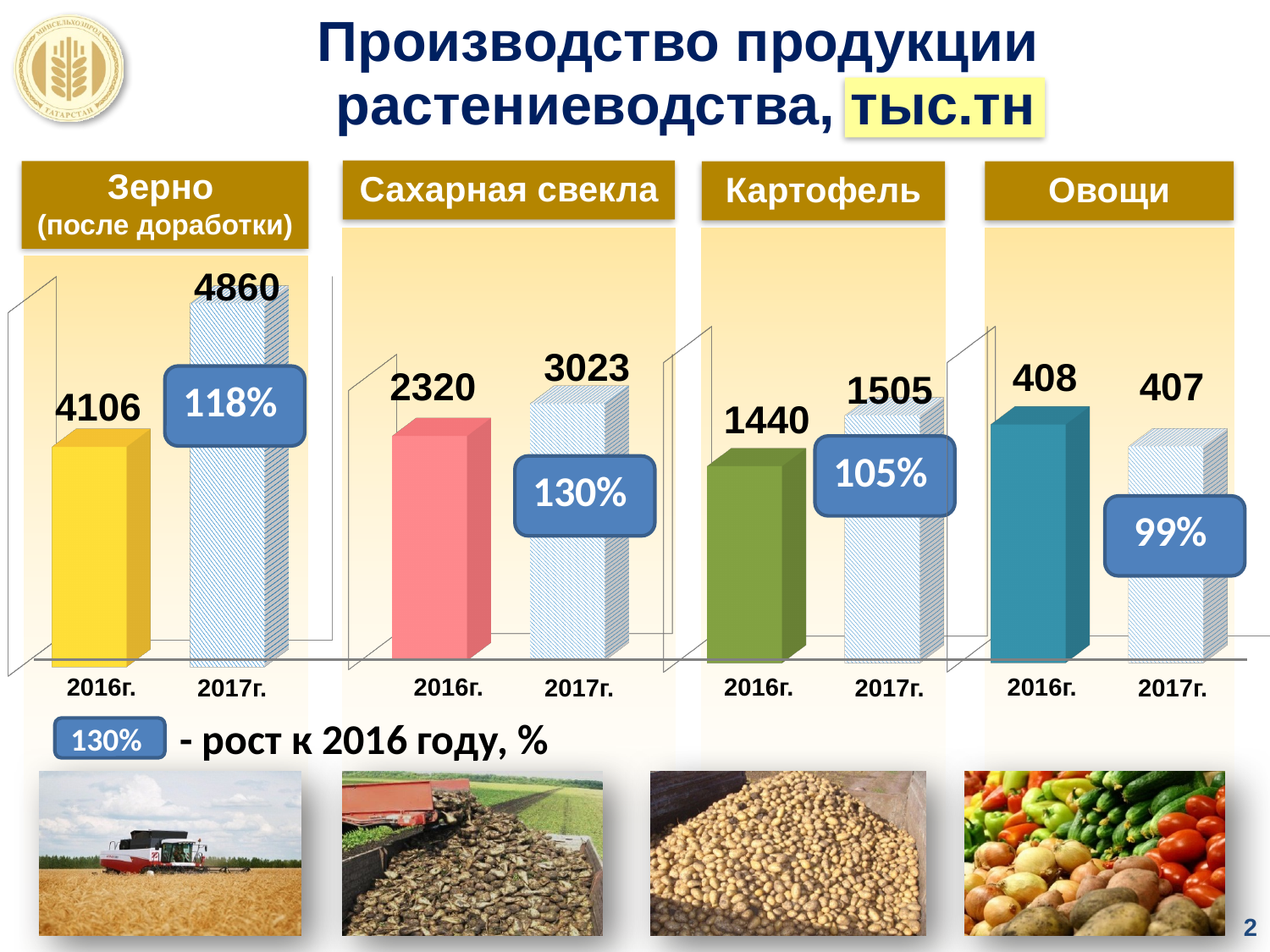
In the Зерно (после доработки) chart, what is the difference between the 2017г. and 2016г. values? 754 What kind of chart is used for Сахарная свекла? bar chart In the Сахарная свекла chart, what is the value for 2017г.? 3023 In the Сахарная свекла chart, what growth percentage relative to 2016 is shown? 130% In the Картофель chart, which year has the larger value, 2016г. or 2017г.? 2017г. In the Зерно (после доработки) chart, what is the value for 2017г.? 4860 In the Овощи chart, what growth percentage relative to 2016 is shown? 99% In the Овощи chart, what is the value for 2017г.? 407 In the Сахарная свекла chart, what is the difference between the 2017г. and 2016г. values? 703 In the Зерно (после доработки) chart, what is the value for 2016г.? 4106 How many bars does the Картофель chart have? 2 In the Картофель chart, what is the value for 2016г.? 1440